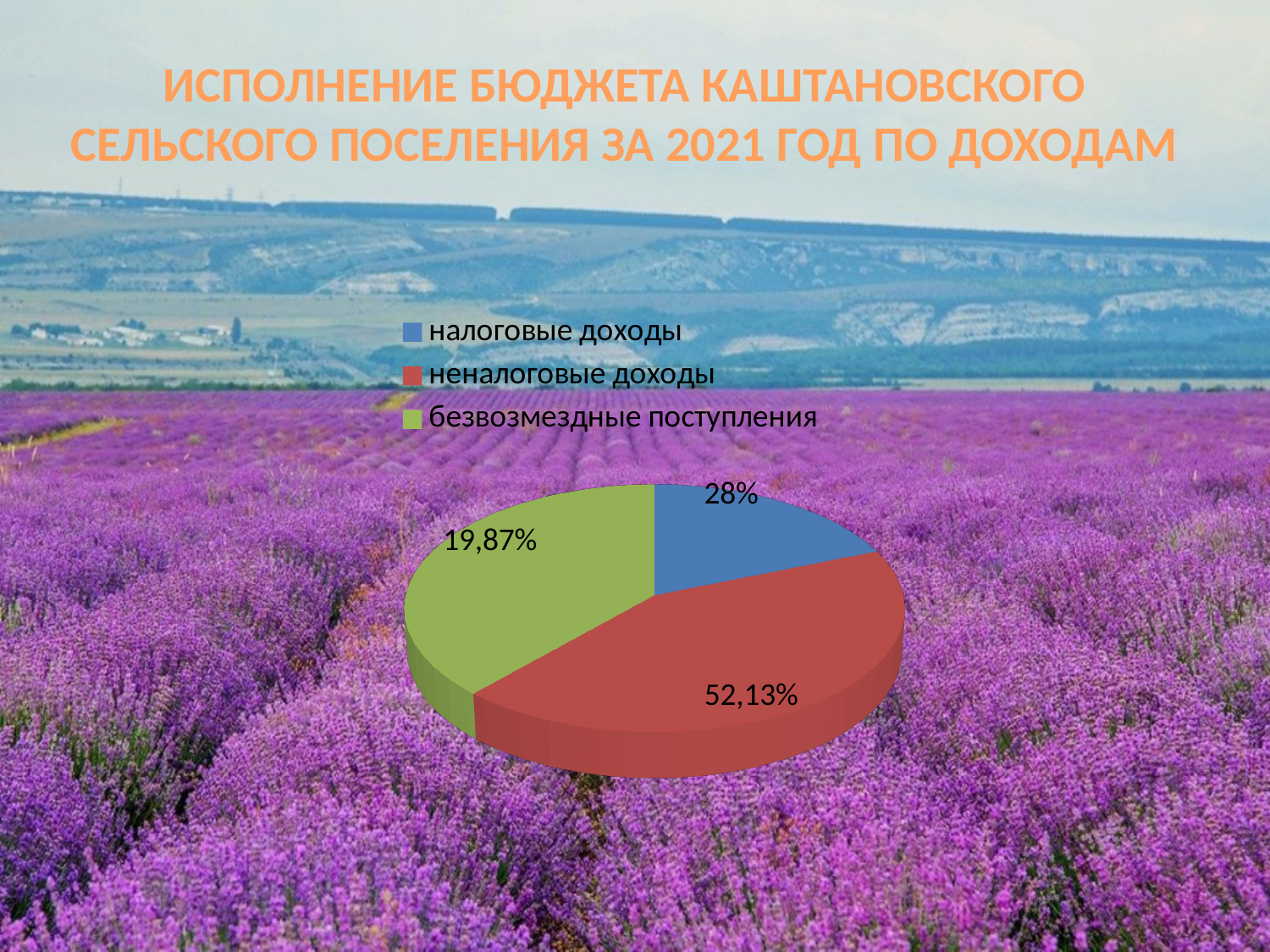
What share of the pie is labelled for неналоговые доходы? 52,13% What is the difference between the shares for налоговые доходы and безвозмездные поступления? 8,13% How many slices does the pie chart have? 3 What is the difference between the shares for неналоговые доходы and налоговые доходы? 24,13% What share of the pie is labelled for налоговые доходы? 28% What share of the pie is labelled for безвозмездные поступления? 19,87% How many entries does the legend list? 3 What colour is the slice for неналоговые доходы? red What kind of chart is shown on the slide? pie chart Which category has the largest slice of the pie? неналоговые доходы